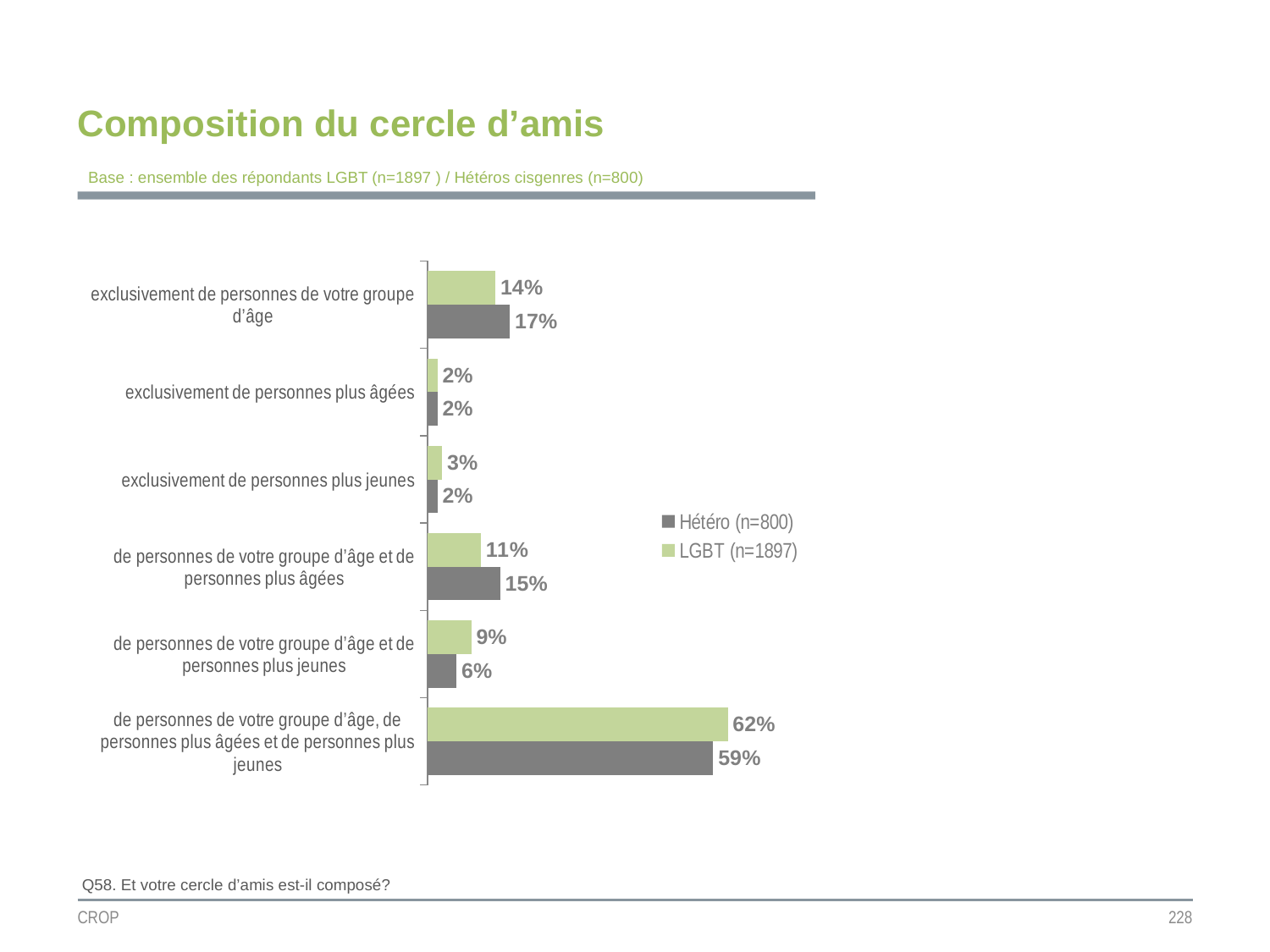
What is the difference between the Hétéro (n=800) and LGBT (n=1897) values for "exclusivement de personnes de votre groupe d'âge"? 3% What is the Hétéro (n=800) value for "de personnes de votre groupe d'âge, de personnes plus âgées et de personnes plus jeunes"? 59% What kind of chart is shown on the slide? Bar chart Which category has the lowest LGBT (n=1897) value? exclusivement de personnes plus âgées For "de personnes de votre groupe d'âge et de personnes plus jeunes", which group has the larger value, LGBT (n=1897) or Hétéro (n=800)? LGBT (n=1897) What is the difference between the LGBT (n=1897) and Hétéro (n=800) values for "de personnes de votre groupe d'âge, de personnes plus âgées et de personnes plus jeunes"? 3% What is the LGBT (n=1897) value for "exclusivement de personnes de votre groupe d'âge"? 14% How many series does the legend list? 2 What is the title of the slide? Composition du cercle d'amis What is the Hétéro (n=800) value for "de personnes de votre groupe d'âge et de personnes plus âgées"? 15% Which category has the highest LGBT (n=1897) value? de personnes de votre groupe d'âge, de personnes plus âgées et de personnes plus jeunes How many categories are shown in the chart? 6